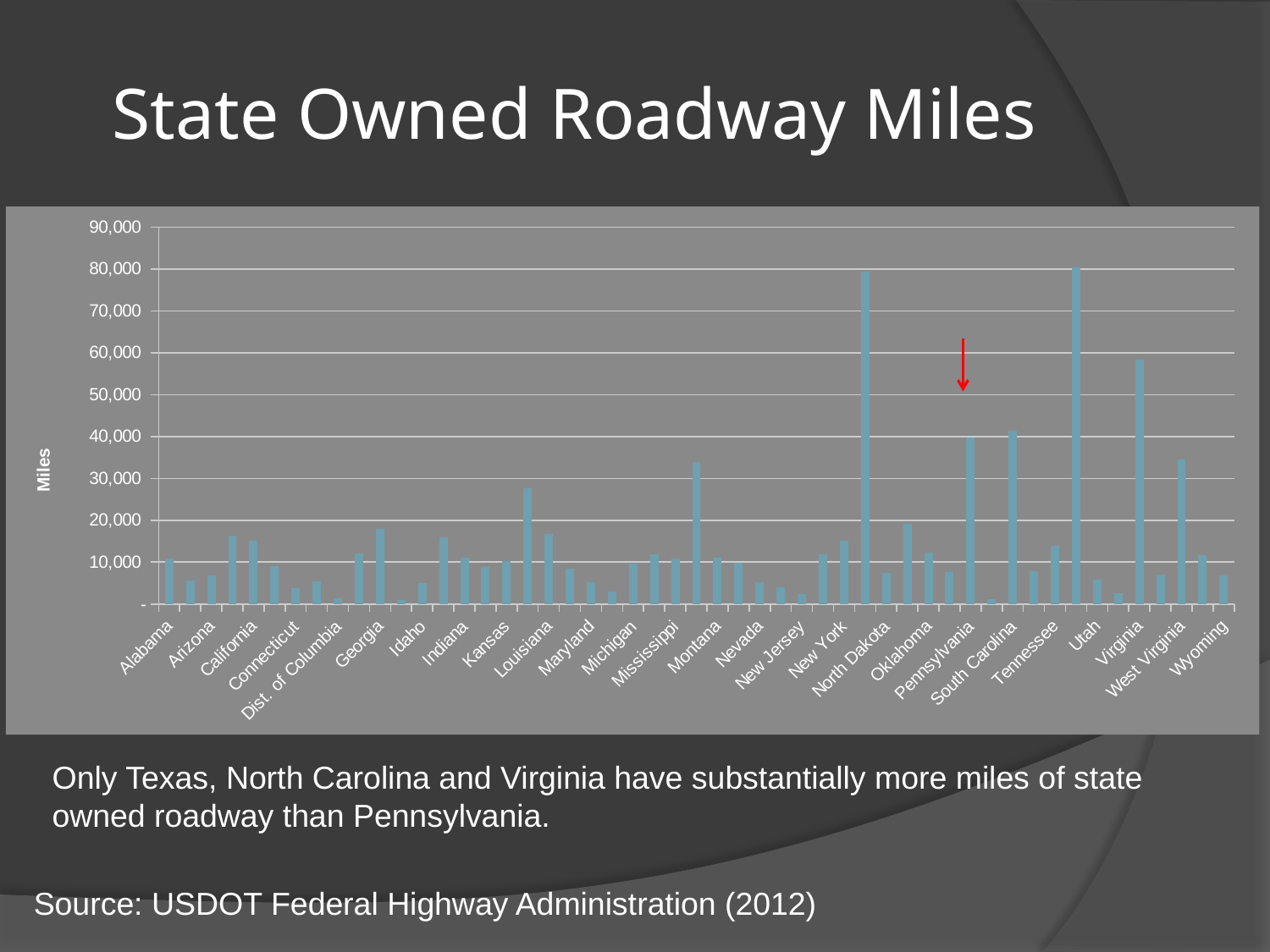
What kind of chart is shown on the slide? bar chart Is the value for West Virginia greater or less than 30,000? greater Is the value for Virginia greater or less than 50,000? greater Which has more state owned roadway miles, Virginia or Pennsylvania? Virginia What is the title of the chart? State Owned Roadway Miles What is the label on the vertical axis of the chart? Miles Is the value for Wyoming greater or less than 10,000? less